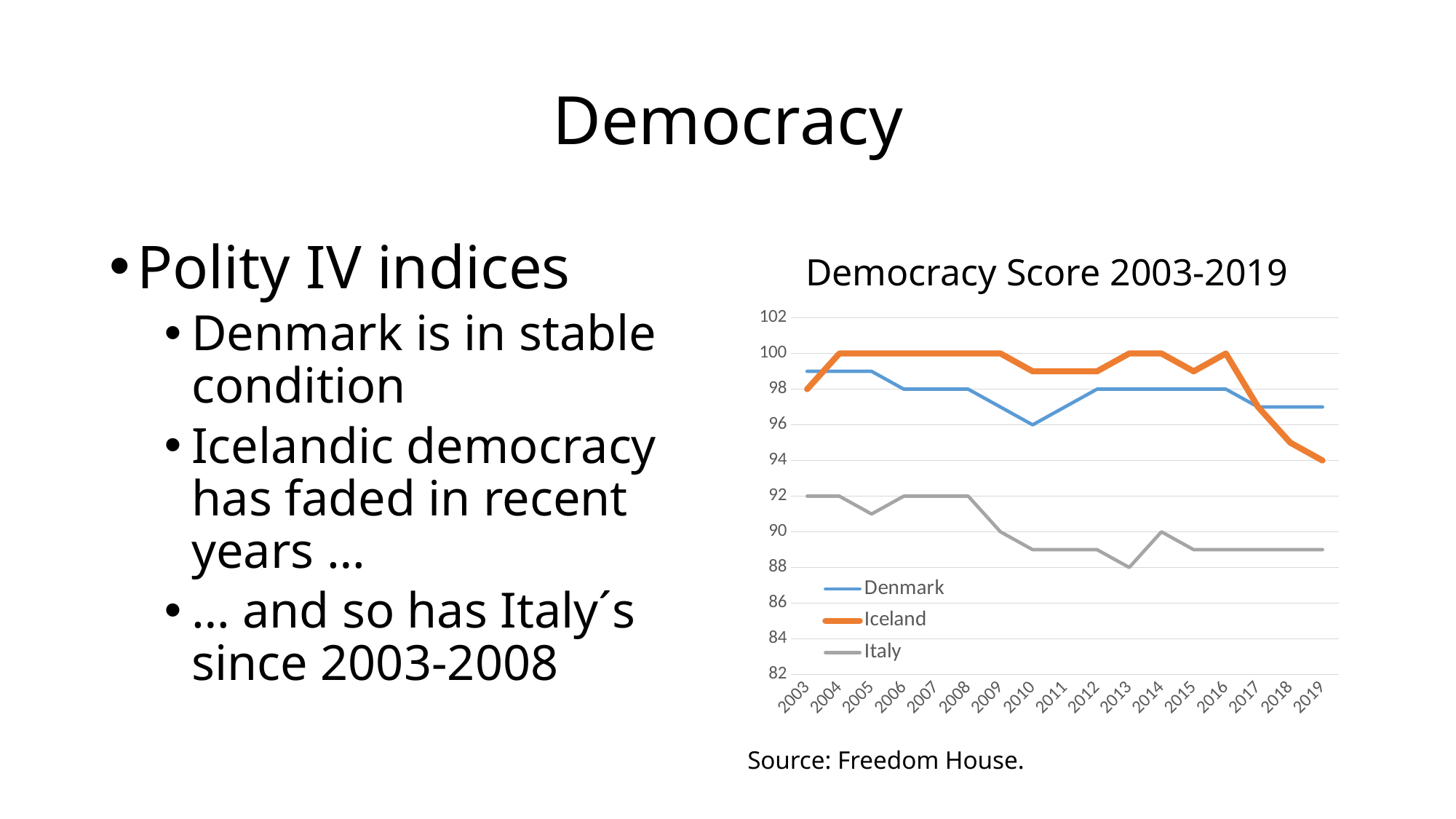
Is the value for Denmark in 2019 greater or less than 96? greater What is the democracy score for Iceland in 2019? 94 What kind of chart is shown on the slide? line chart Which series has the highest value in 2019? Denmark Is the value for Italy in 2019 greater or less than 90? less What is the democracy score for Denmark in 2010? 96 Does the Iceland line rise or fall from 2016 to 2019? fall How many years are plotted along the x axis of the chart? 17 Which series has the higher value in 2008, Iceland or Italy? Iceland How many series does the legend of the chart list? 3 What is the difference between Iceland's score in 2016 and its score in 2019? 6 What is the democracy score for Italy in 2013? 88